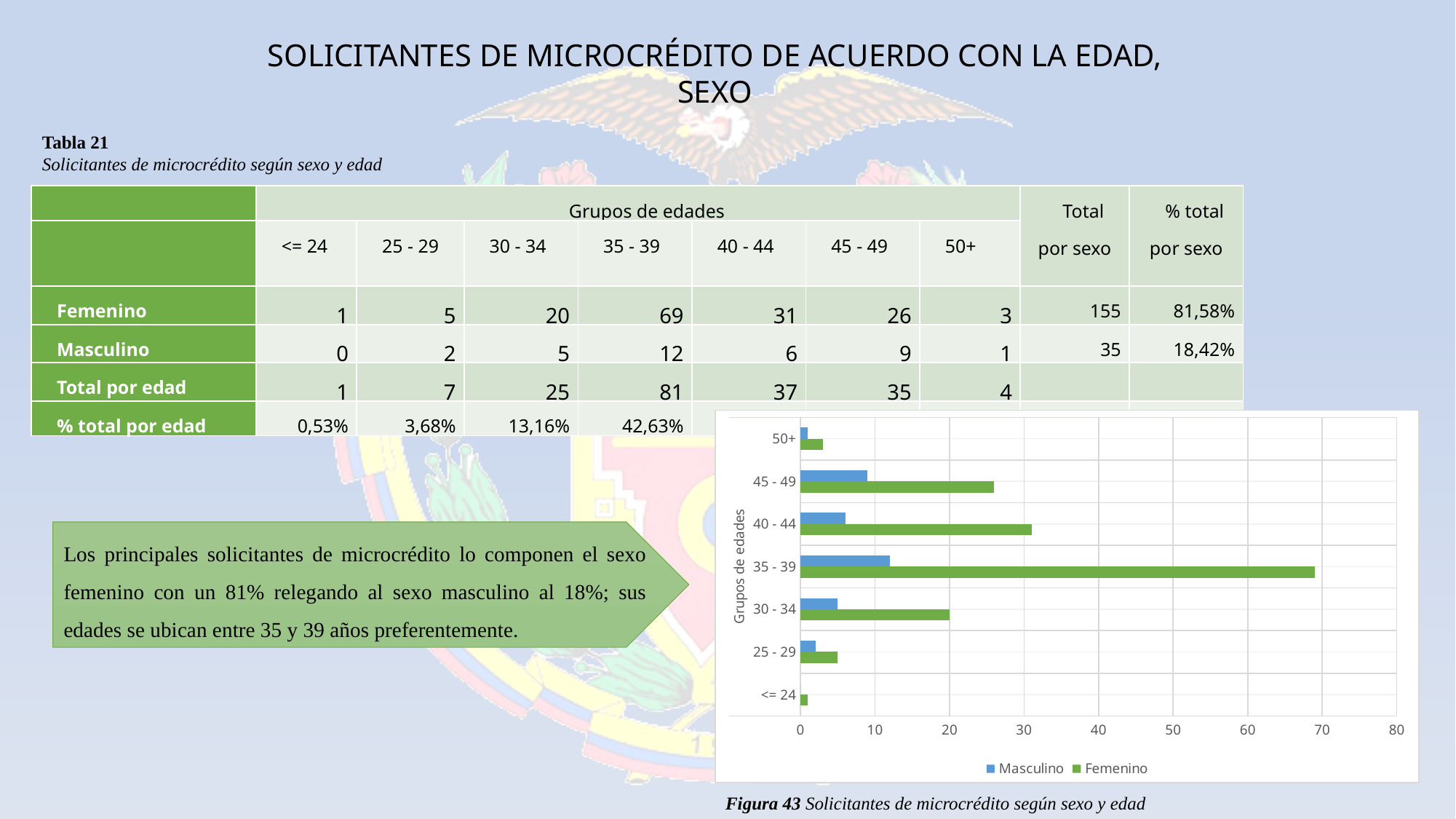
What kind of chart is shown in Figura 43? bar chart In the chart, which is larger for the 40 - 44 age group, Masculino or Femenino? Femenino Is the Femenino value for the 35 - 39 age group greater or less than 60? greater What is the Masculino value for the 45 - 49 age group? 9 What is the Femenino value for the 35 - 39 age group? 69 Which age group has the longest Femenino bar in the chart? 35 - 39 In the chart, which age group has a larger Femenino bar, 30 - 34 or 45 - 49? 45 - 49 How many age groups are shown on the vertical axis of the bar chart? 7 What is the label of the vertical axis of the bar chart? Grupos de edades How many series does the legend of the bar chart list? 2 Is the Masculino value for the 45 - 49 age group greater or less than 10? less Which age group has the shortest Femenino bar in the chart? <= 24